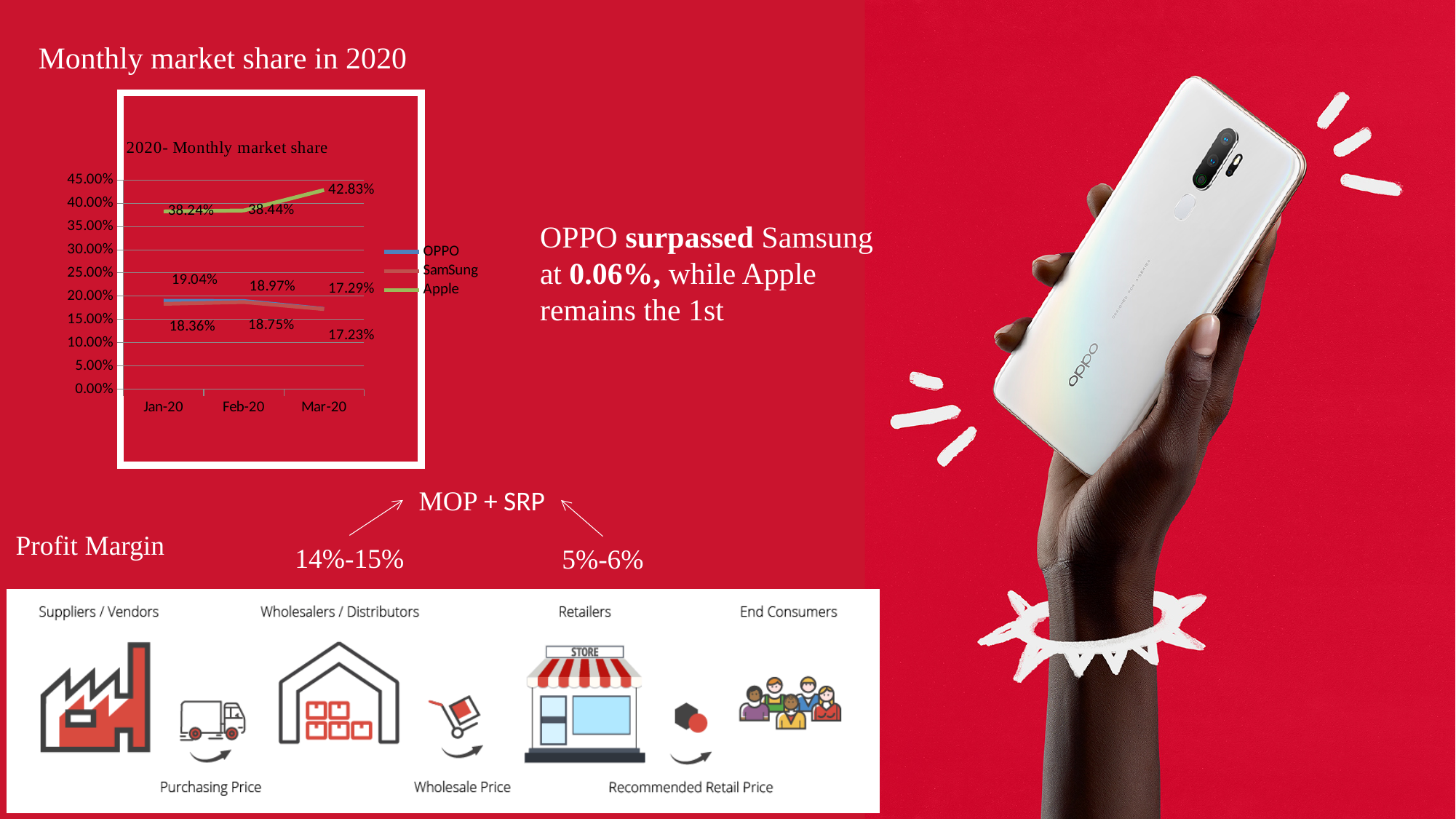
In the '2020- Monthly market share' chart, is Apple's Mar-20 value greater or less than 40.00%? greater Does Apple's market share rise or fall from Jan-20 to Mar-20 in the '2020- Monthly market share' chart? rise By how much did Apple's market share increase from Feb-20 to Mar-20 in the '2020- Monthly market share' chart? 4.39% What is Apple's market share in Jan-20 in the '2020- Monthly market share' chart? 38.24% In the '2020- Monthly market share' chart, is Apple's Jan-20 value greater or less than 35.00%? greater Which brand has the highest market share in Mar-20 in the '2020- Monthly market share' chart? Apple Which colour represents Apple in the '2020- Monthly market share' chart? green How many months are shown on the x axis of the '2020- Monthly market share' chart? 3 How many series does the legend of the '2020- Monthly market share' chart list? 3 What is Apple's market share in Feb-20 in the '2020- Monthly market share' chart? 38.44% What type of chart is shown under 'Monthly market share in 2020'? line chart What is Apple's market share in Mar-20 in the '2020- Monthly market share' chart? 42.83%